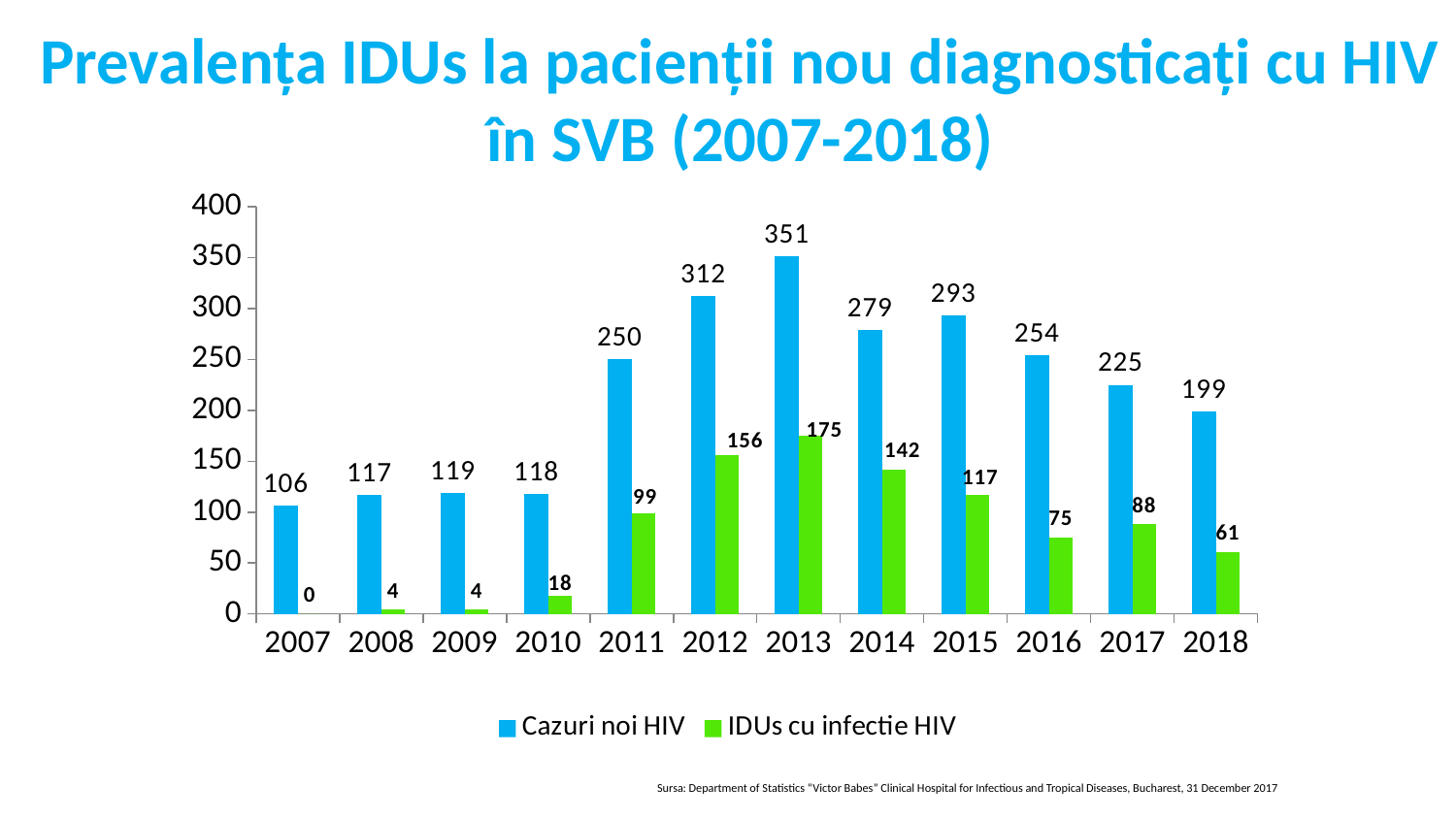
Which year has the lowest value for Cazuri noi HIV? 2007 Which year has the highest value for IDUs cu infectie HIV? 2013 What is the value of Cazuri noi HIV in 2013? 351 Is the value for Cazuri noi HIV in 2018 greater or less than 150? greater What colour are the bars for IDUs cu infectie HIV? green Does the value for Cazuri noi HIV rise or fall from 2013 to 2018? fall Which is larger: IDUs cu infectie HIV in 2014 or in 2015? 2014 What is the difference between Cazuri noi HIV and IDUs cu infectie HIV in 2012? 156 How many series does the legend list? 2 What kind of chart is shown on the slide? bar chart What is the value of IDUs cu infectie HIV in 2016? 75 How many years are shown on the x axis? 12